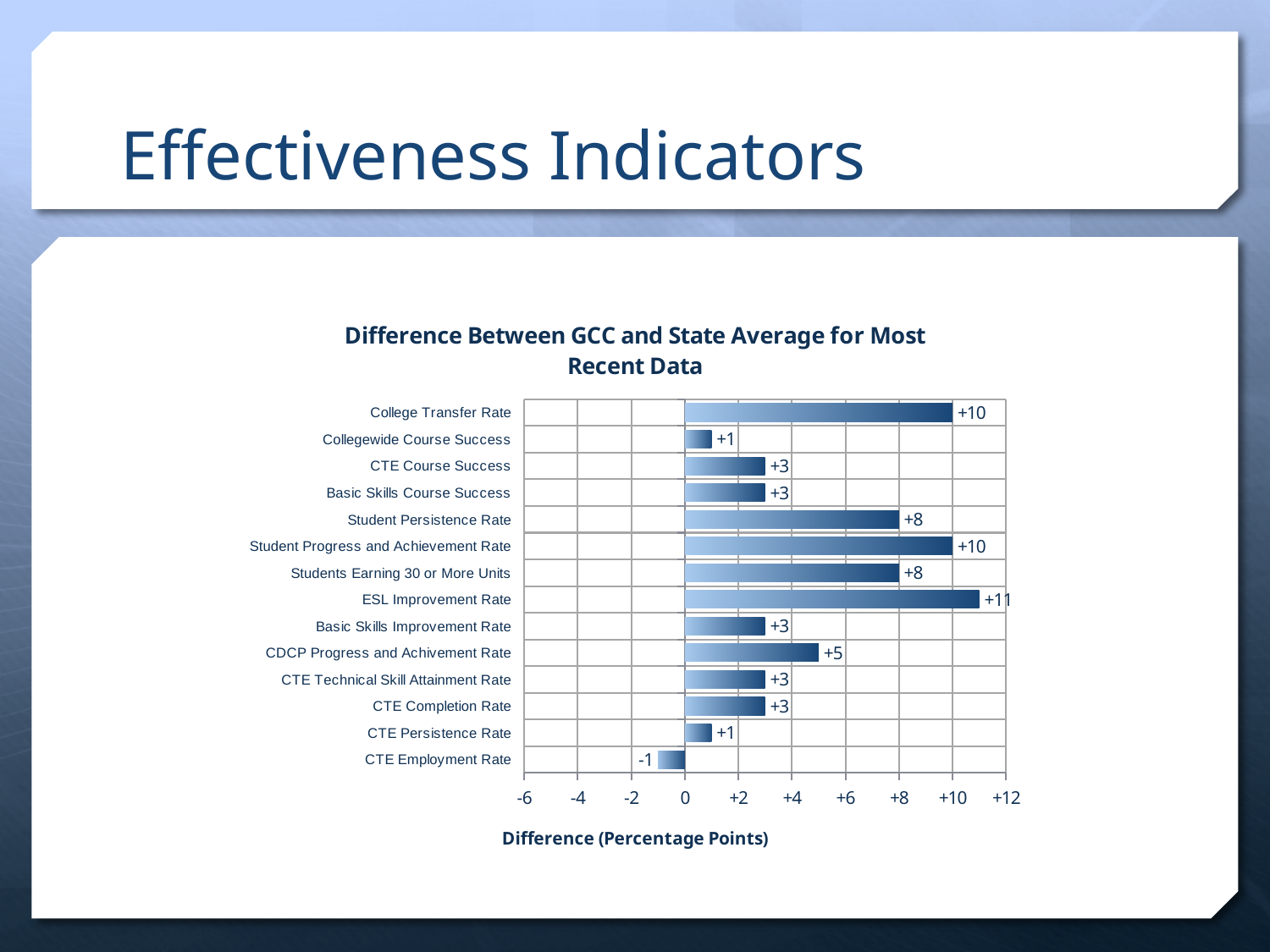
What is the title of the chart? Difference Between GCC and State Average for Most Recent Data What kind of chart is shown on the slide? Bar chart What is the difference between the values for ESL Improvement Rate and Student Persistence Rate? 3 What is the value for CDCP Progress and Achivement Rate? +5 How many categories are shown in the chart? 14 Is the value for Students Earning 30 or More Units greater or less than +6? greater What is the value for CTE Employment Rate? -1 Which category has the lowest value? CTE Employment Rate Which category has the highest value? ESL Improvement Rate Which is larger, the value for Student Persistence Rate or the value for CTE Course Success? Student Persistence Rate What is the value for College Transfer Rate? +10 What is the label of the horizontal axis? Difference (Percentage Points)